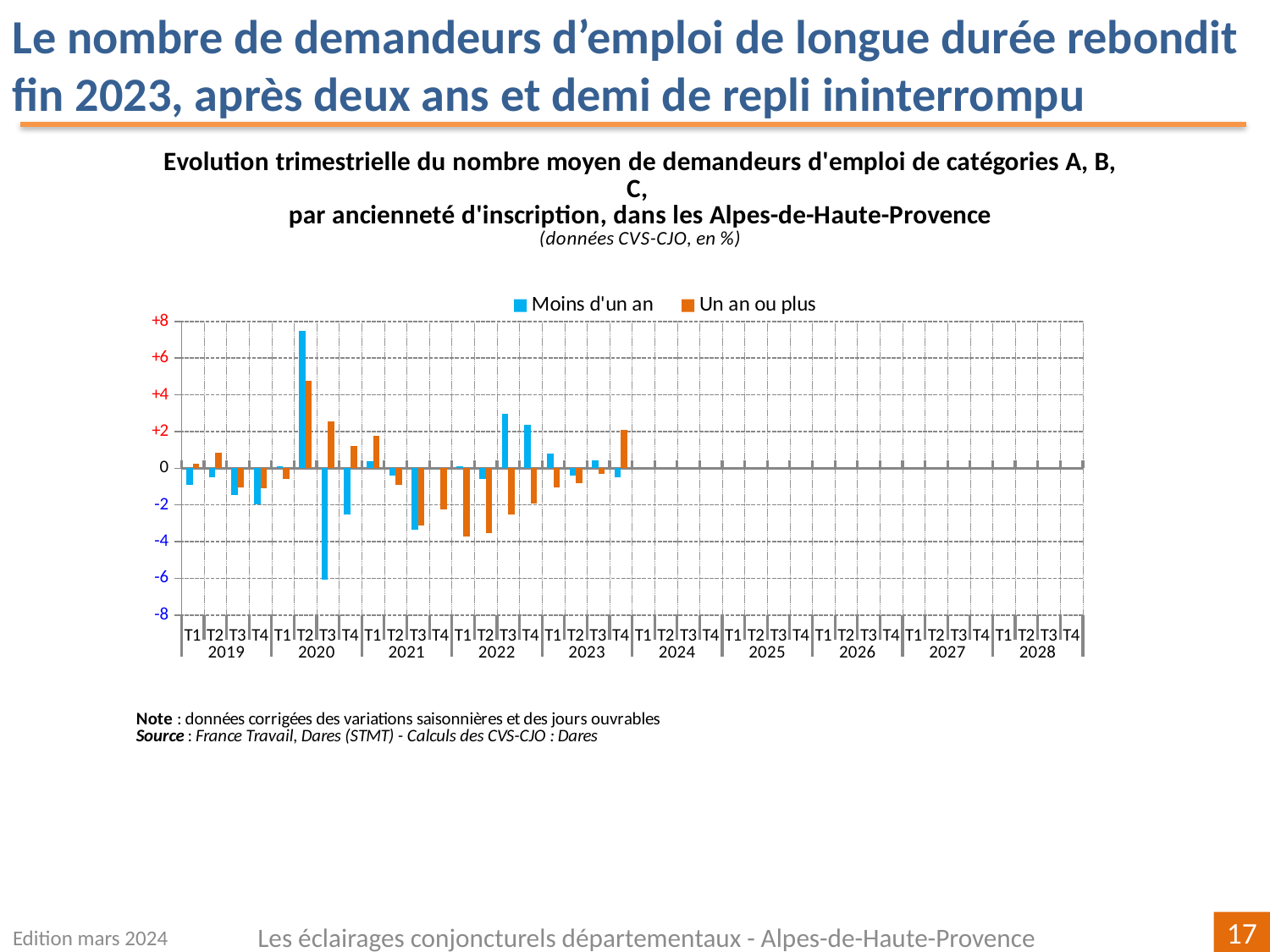
In which quarter is the value for 'Un an ou plus' the highest? T2 2020 What kind of chart is shown on the slide? bar chart In which quarter is the value for 'Moins d'un an' the highest? T2 2020 How many series does the legend list? 2 In T4 2023, which series has the larger value, 'Moins d'un an' or 'Un an ou plus'? Un an ou plus In which quarter is the value for 'Moins d'un an' the lowest? T3 2020 Is the value for 'Moins d'un an' in T3 2020 greater or less than -4? less Is the value for 'Moins d'un an' in T2 2020 greater or less than +6? greater What are the two series named in the legend? Moins d'un an; Un an ou plus Is the value for 'Un an ou plus' in T2 2020 greater or less than +4? greater How many years are labelled along the x axis? 10 Which colour represents the series 'Un an ou plus'? orange